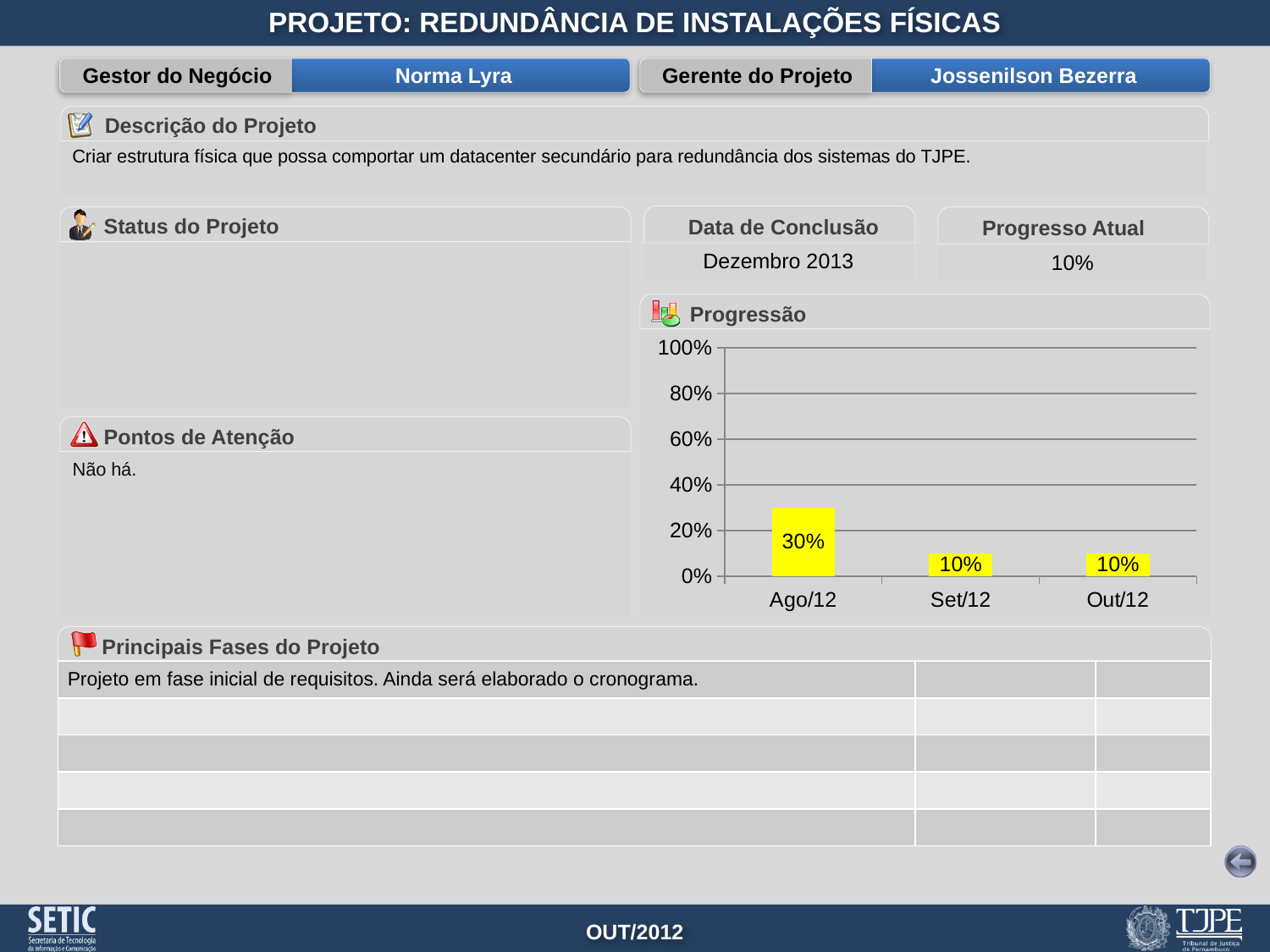
Is the value for Set/12 in the Progressão chart greater or less than 20%? less What is the difference between the values for Ago/12 and Set/12 in the Progressão chart? 20% What kind of chart is the Progressão chart? bar chart How many months are shown on the x axis of the Progressão chart? 3 What is the value for Set/12 in the Progressão chart? 10% What is the value for Ago/12 in the Progressão chart? 30% Which month has the highest value in the Progressão chart? Ago/12 Is the value for Ago/12 in the Progressão chart greater or less than 20%? greater Do the values in the Progressão chart rise or fall from Ago/12 to Set/12? fall What is the title of the chart on the slide? Progressão What is the value for Out/12 in the Progressão chart? 10% Which is larger in the Progressão chart, the value for Ago/12 or the value for Out/12? Ago/12